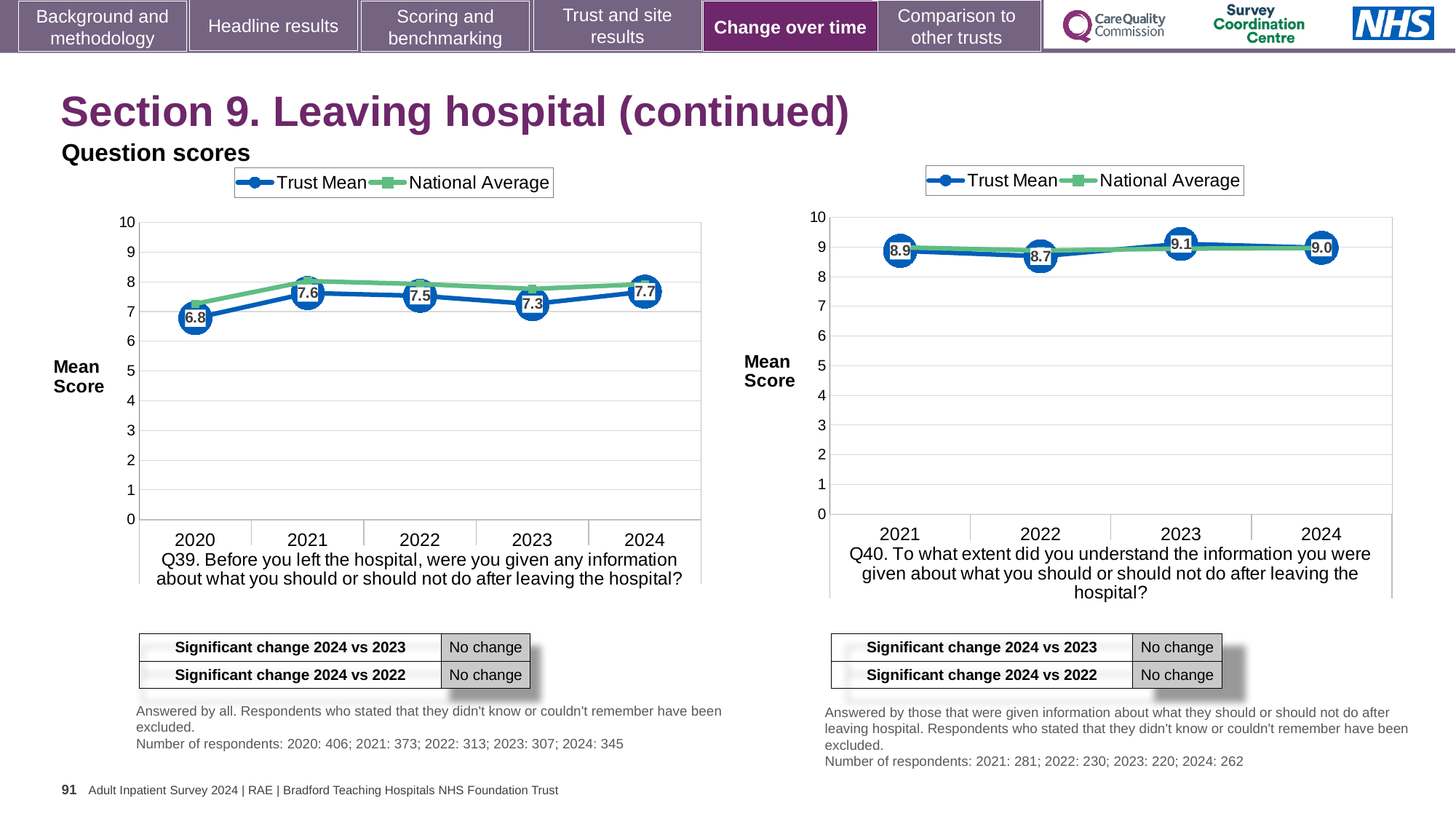
On the Q39 chart (left), what is the Trust Mean score for 2020? 6.8 On the Q40 chart (right), is the Trust Mean score for 2023 larger than the Trust Mean score for 2022? Yes On the Q39 chart (left), which year has the highest Trust Mean score? 2024 On the Q40 chart (right), how many series does the legend list? 2 On the Q40 chart (right), which year has the highest Trust Mean score? 2023 On the Q40 chart (right), what is the Trust Mean score for 2022? 8.7 On the Q39 chart (left), how many years are plotted on the x axis? 5 On the Q39 chart (left), which year has the lowest Trust Mean score? 2020 On the Q39 chart (left), what is the difference between the Trust Mean scores for 2024 and 2020? 0.9 On the Q39 chart (left), is the National Average for 2020 greater or less than 8? less What type of chart is the Q40 chart (right)? Line chart On the Q39 chart (left), what is the Trust Mean score for 2024? 7.7